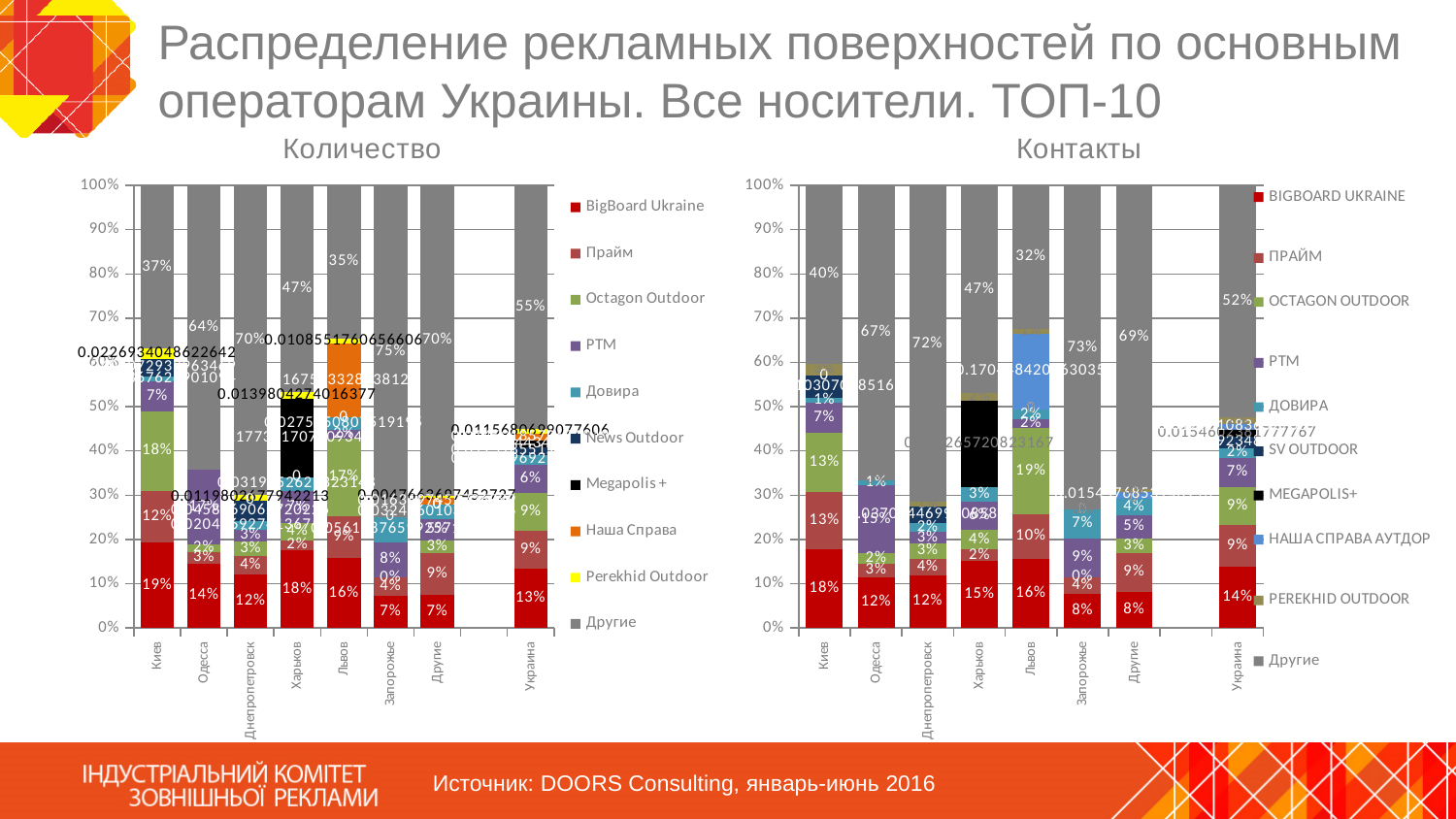
How many categories are shown on the x axis of the Контакты chart? 8 On the Контакты chart, which category has the largest Другие share? Запорожье On the Контакты chart, what share does the Другие segment hold for Львов? 32% On the Количество chart, which city has the largest Другие share? Запорожье On the Контакты chart, what share does BigBoard Ukraine hold for Украина? 14% On the Контакты chart, which is larger: the BigBoard Ukraine share for Киев or for Харьков? Киев On the Количество chart, what is the difference between the BigBoard Ukraine shares for Киев and Днепропетровск? 7% On the Количество chart, which category has the smallest Другие share? Львов On the Количество chart, what share does BigBoard Ukraine hold in Киев? 19% What type of chart is the Контакты chart? Stacked bar chart How many series does the legend of the Количество chart list? 10 On the Количество chart, what share does the Другие segment hold for Запорожье? 75%